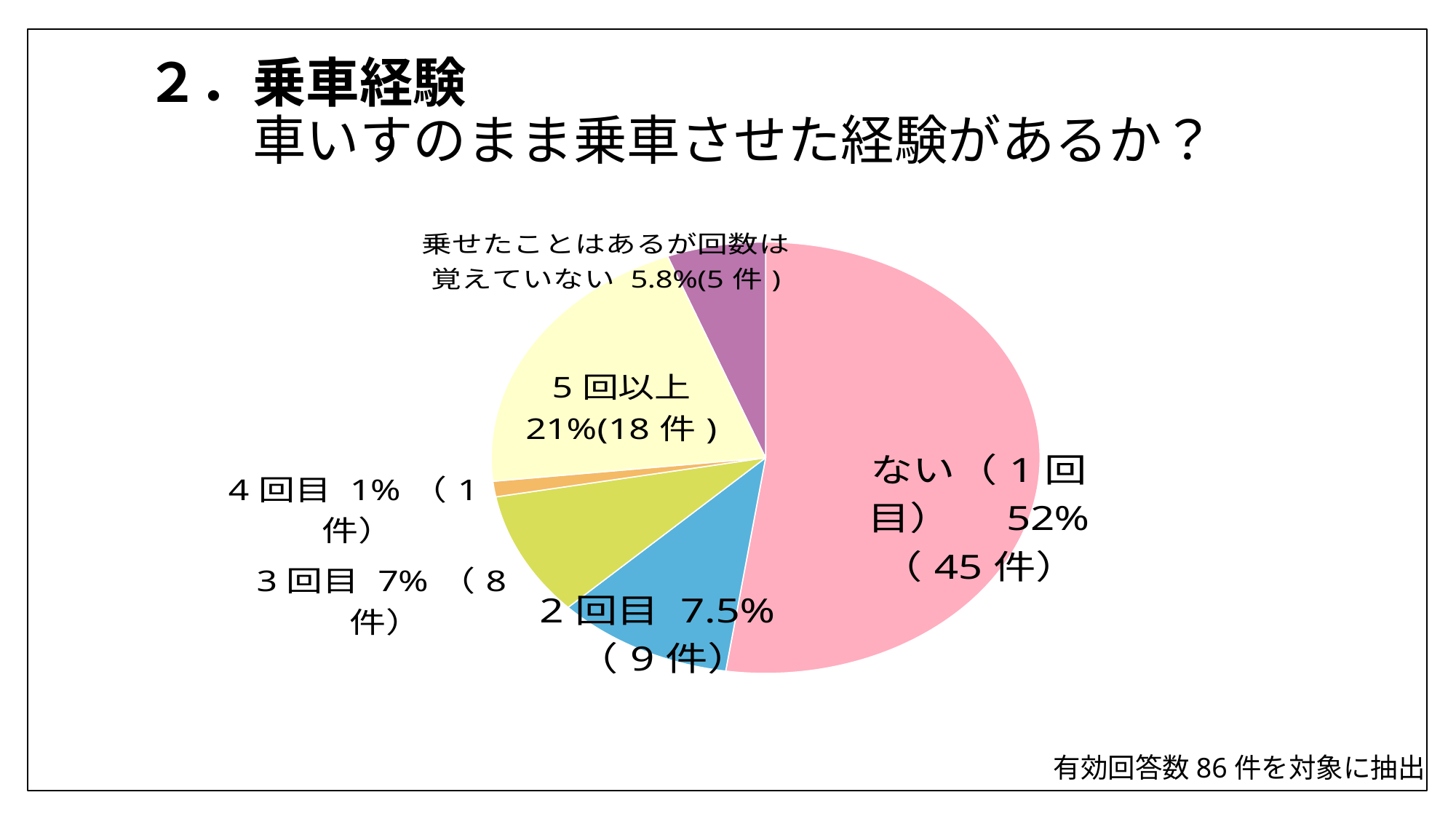
Which slice of the pie chart is the smallest? 4回目 According to the note at the bottom of the slide, how many valid responses (有効回答数) were used? 86件 What is the difference in number of responses between ない（1回目） and 2回目? 36件 What percentage is shown for the slice labelled 2回目? 7.5% How many responses (件) are shown for the slice labelled 乗せたことはあるが回数は覚えていない? 5件 What is the difference in number of responses between 5回以上 and 3回目? 10件 Which slice of the pie chart is the largest? ない（1回目） What percentage is shown for the slice labelled ない（1回目）? 52% What type of chart is shown on the slide? pie chart How many slices does the pie chart have? 6 How many responses (件) are shown for the slice labelled 5回以上? 18件 Which slice is larger, 5回以上 or 2回目? 5回以上